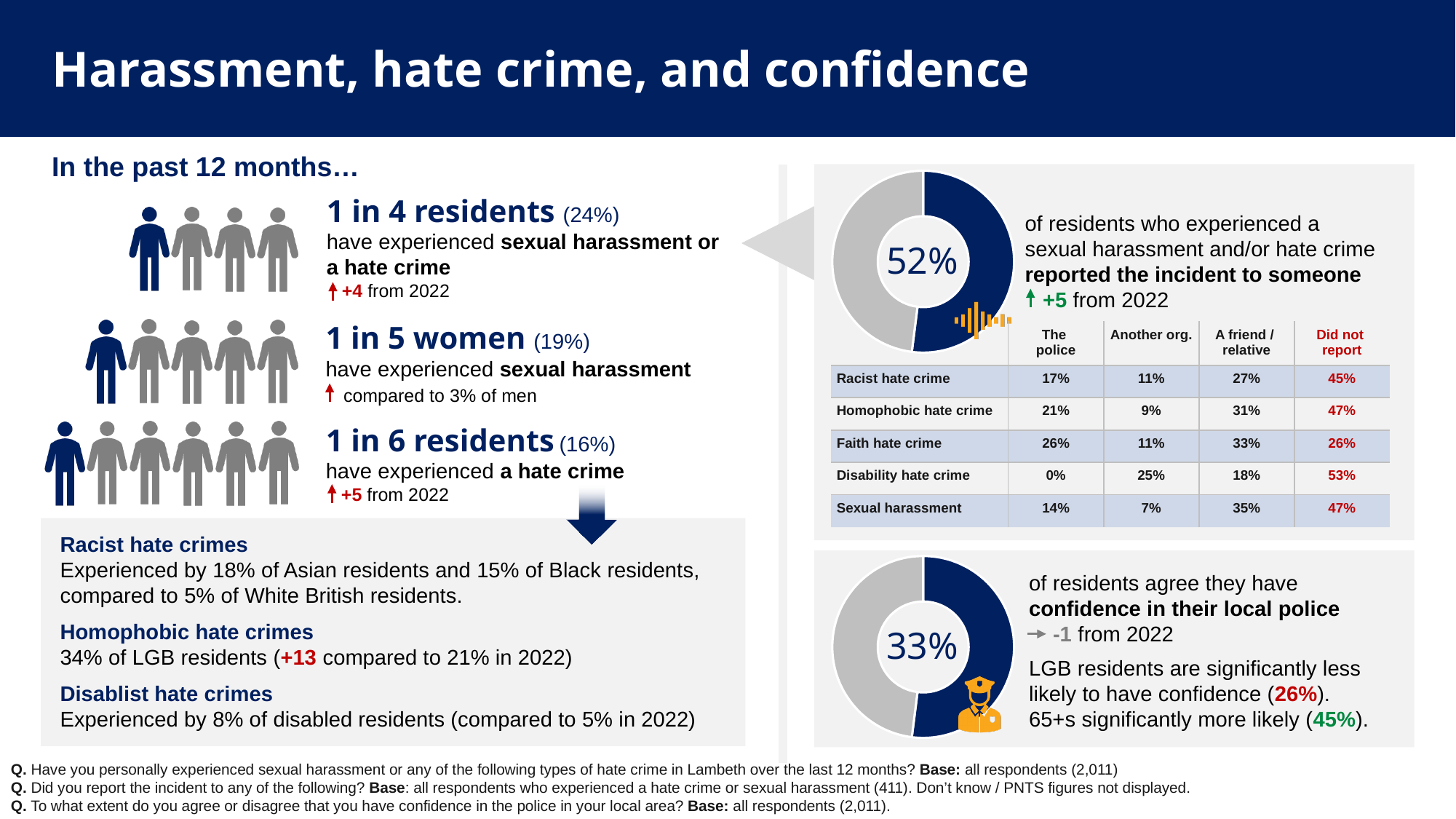
In the upper-right donut chart, what share of residents did not report the incident to someone (the grey portion)? 48% Is the highlighted share in the upper-right donut chart (reported the incident) greater or less than 50%? greater What is the difference in percentage points between the 52% who reported the incident and the 33% who have confidence in their local police? 19 percentage points How many donut charts are shown on the slide? 2 Which donut chart shows the larger highlighted share: the one for reporting the incident to someone or the one for confidence in local police? Reporting the incident to someone (52%) What kind of chart is used to show the share of residents who reported the incident to someone? Pie (donut) chart In the lower-right donut chart, what percentage of residents agree they have confidence in their local police? 33% In the upper-right donut chart, what percentage of residents who experienced sexual harassment and/or hate crime reported the incident to someone? 52% According to the annotation next to the lower-right donut chart, how has the share of residents with confidence in their local police changed from 2022? -1 According to the annotation next to the upper-right donut chart, how has the share of residents reporting the incident changed from 2022? +5